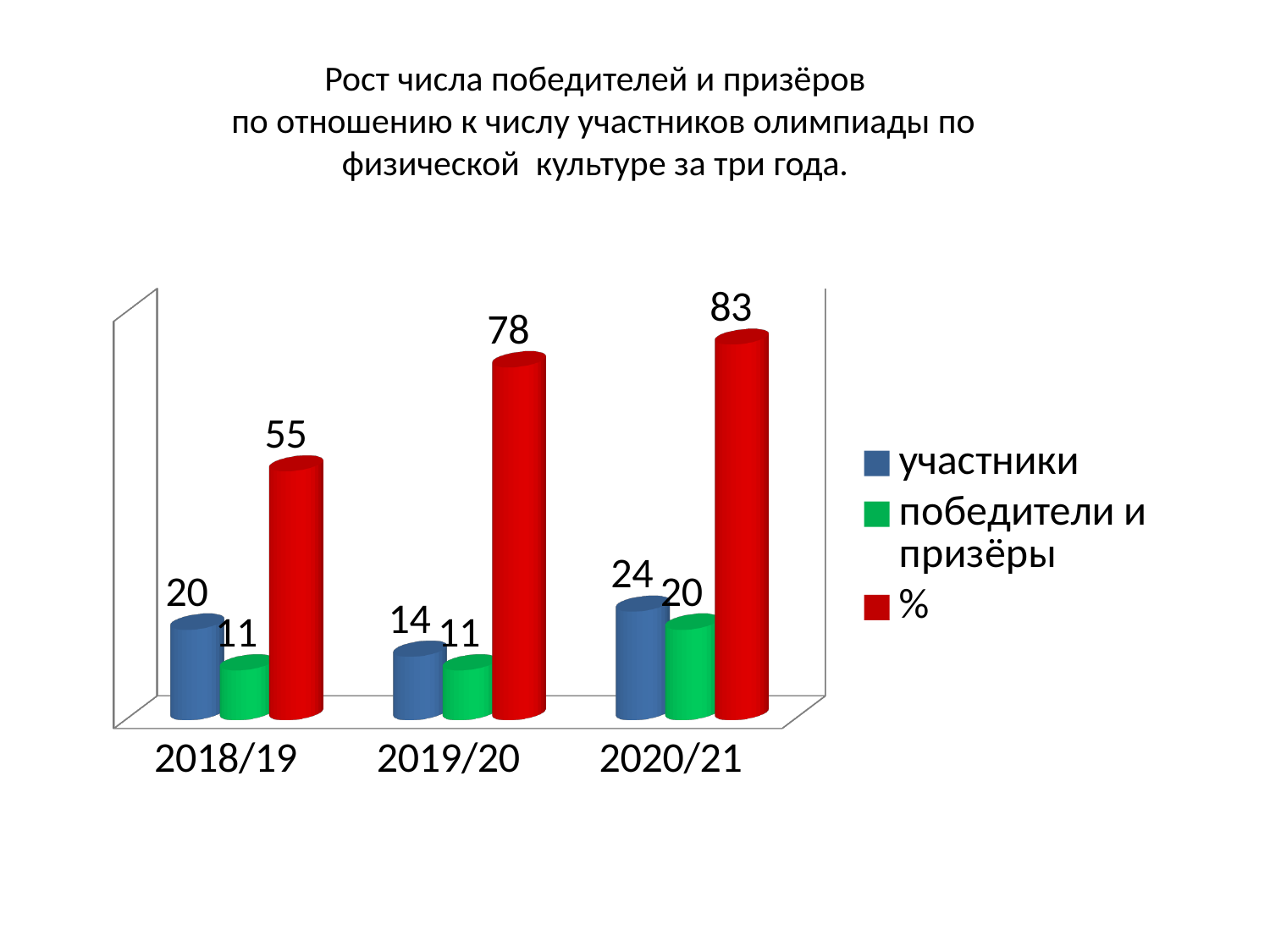
Do the % values rise or fall from 2018/19 to 2020/21? rise How many years (categories) are shown on the x axis? 3 What is the value for победители и призёры in 2020/21? 20 Which year has the lowest value for участники? 2019/20 What is the value for участники in 2018/19? 20 Which year has the highest % value? 2020/21 How many series does the legend list? 3 What is the % value for 2019/20? 78 What is the difference between the % values for 2020/21 and 2018/19? 28 What colour are the bars for the % series? red Which is larger: участники in 2020/21 or участники in 2019/20? участники in 2020/21 What kind of chart is shown on the slide? bar chart